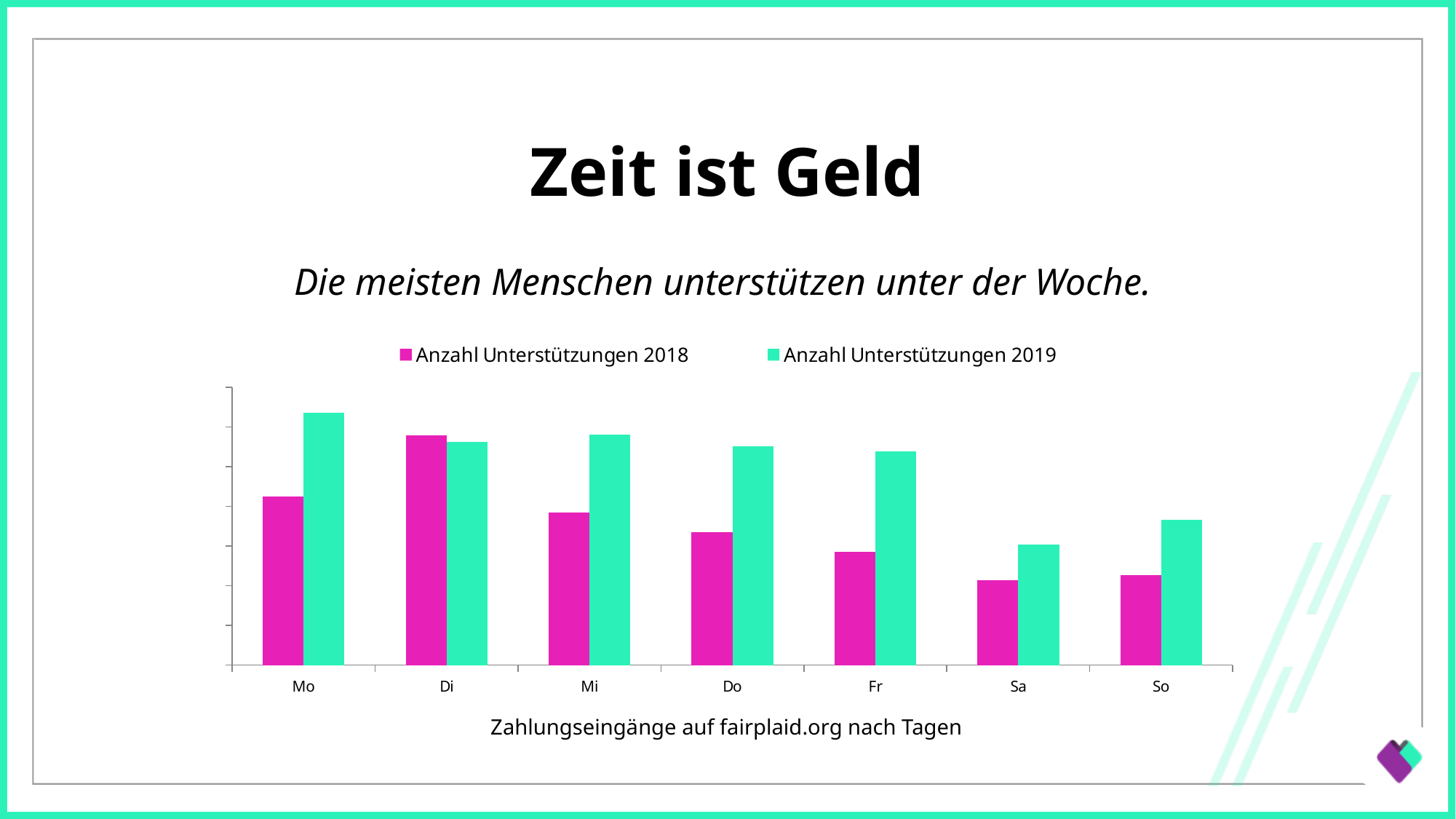
For Fr, which series is larger: Anzahl Unterstützungen 2018 or Anzahl Unterstützungen 2019? Anzahl Unterstützungen 2019 How many series does the legend list? 2 Which day has the lowest value for Anzahl Unterstützungen 2019? Sa What colour are the bars for Anzahl Unterstützungen 2019? turquoise (green) For Anzahl Unterstützungen 2018, which is larger: Mo or Sa? Mo What is the axis title shown below the x axis? Zahlungseingänge auf fairplaid.org nach Tagen Which day has the highest value for Anzahl Unterstützungen 2018? Di Which day has the highest value for Anzahl Unterstützungen 2019? Mo What kind of chart is shown on the slide? bar chart Do the values for Anzahl Unterstützungen 2018 rise or fall from Di to Sa? fall For Mo, which series is larger: Anzahl Unterstützungen 2018 or Anzahl Unterstützungen 2019? Anzahl Unterstützungen 2019 How many categories (days) are shown on the x axis? 7